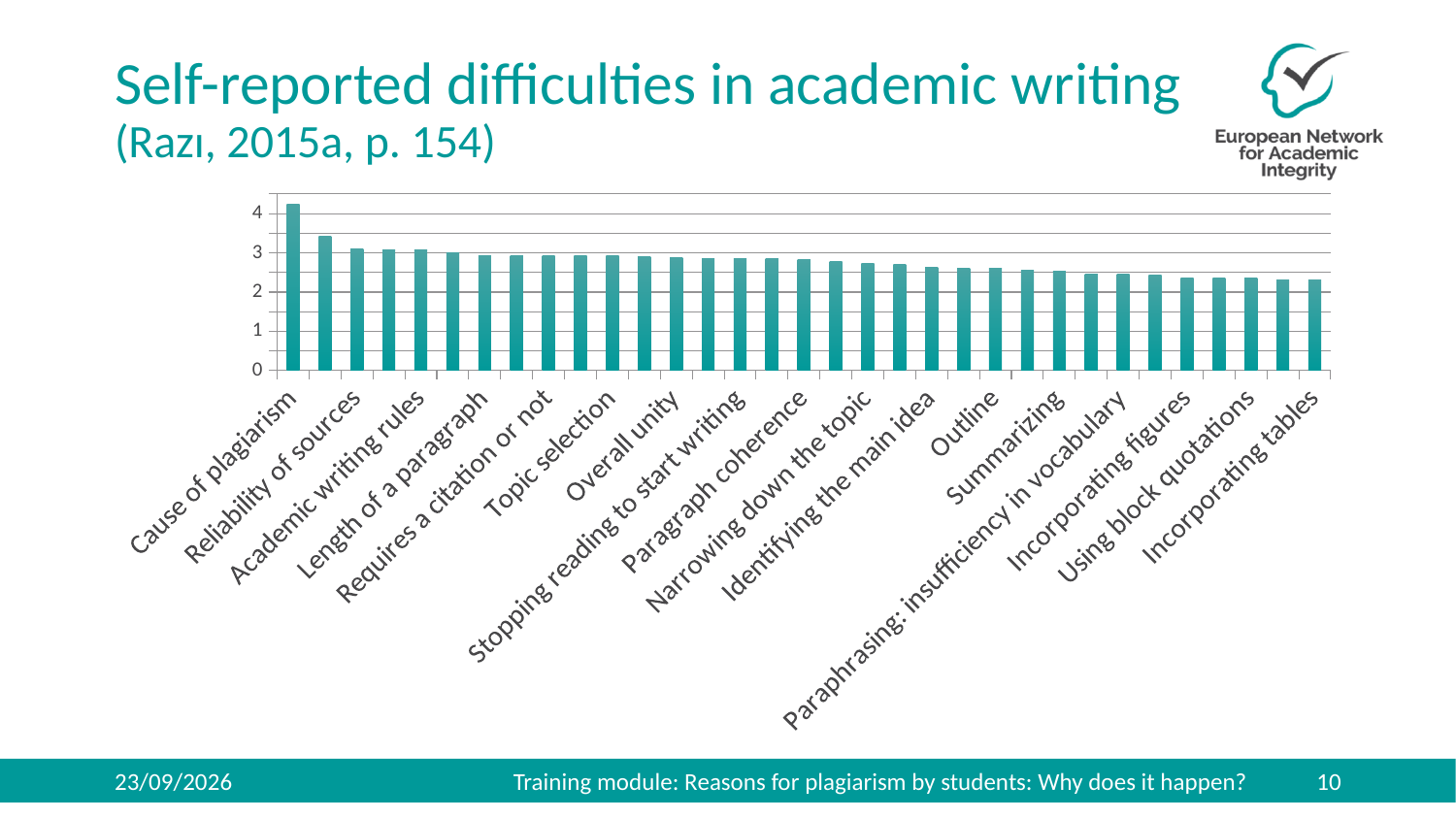
Is the value for Outline greater or less than 3? less Which is larger, the value for Reliability of sources or the value for Summarizing? Reliability of sources Do the bar values generally rise or fall from left to right along the x axis? fall Is the value for Incorporating tables greater or less than 3? less Which category has the highest value in the chart? Cause of plagiarism Is the value for Topic selection greater or less than 2? greater What is the title of the chart on the slide? Self-reported difficulties in academic writing What kind of chart is shown on the slide? bar chart Which is larger, the value for Cause of plagiarism or the value for Incorporating tables? Cause of plagiarism What colour are the bars in the chart? teal